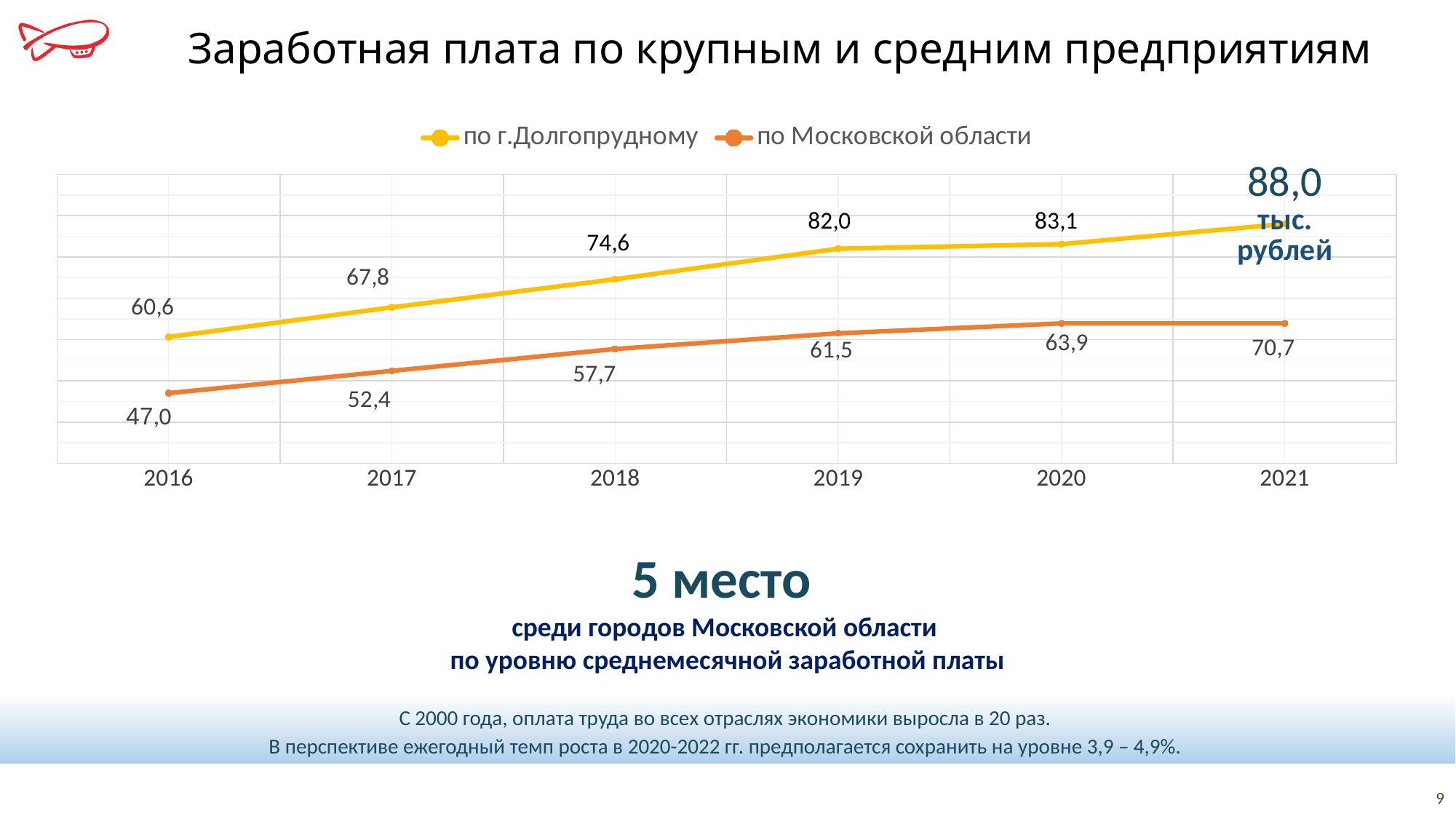
In which year is the value for "по г.Долгопрудному" highest? 2021 What is the value for "по Московской области" in 2019? 61,5 What is the value for "по г.Долгопрудному" in 2018? 74,6 What colour is the line for "по г.Долгопрудному"? Yellow What is the value for "по г.Долгопрудному" in 2021? 88,0 What is the difference between the "по г.Долгопрудному" and "по Московской области" values in 2016? 13,6 Do the values for "по Московской области" rise or fall from 2016 to 2021? Rise Which series has the larger value in 2020, "по г.Долгопрудному" or "по Московской области"? по г.Долгопрудному How many series does the legend list? 2 How many years are plotted along the x axis? 6 In which year is the value for "по Московской области" lowest? 2016 What type of chart is shown on the slide? Line chart